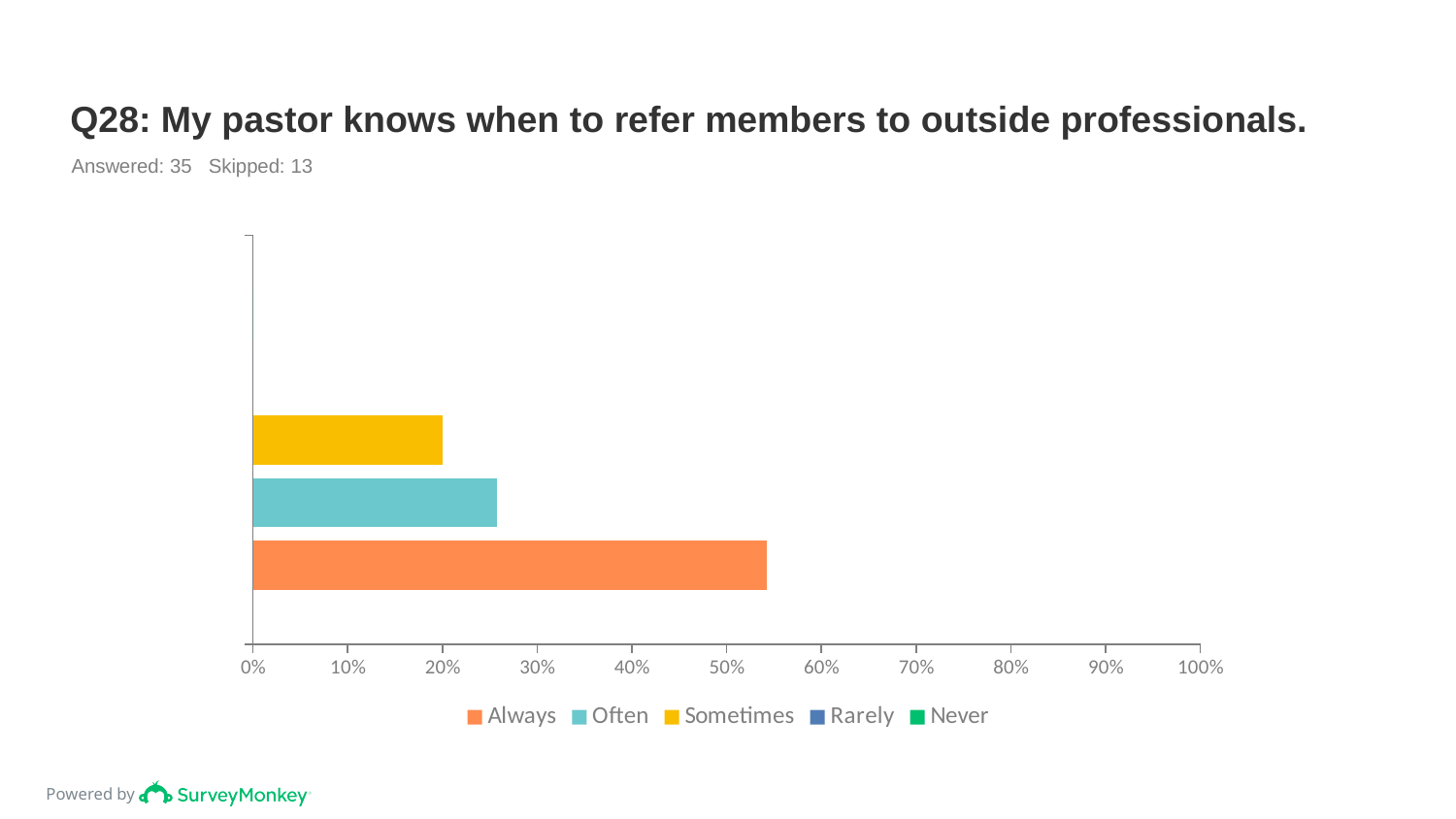
What kind of chart is shown on the slide? bar chart What is the value for Sometimes? 20% How many response categories have a visible bar in the chart? 3 Which is larger, the value for Always or the value for Often? Always Is the value for Always greater or less than 50%? greater What is the title of the chart? Q28: My pastor knows when to refer members to outside professionals. Which response category has the highest value? Always Which is larger, the value for Often or the value for Sometimes? Often Is the value for Often greater or less than 20%? greater How many series does the legend list? 5 Is the value for Always greater or less than 60%? less